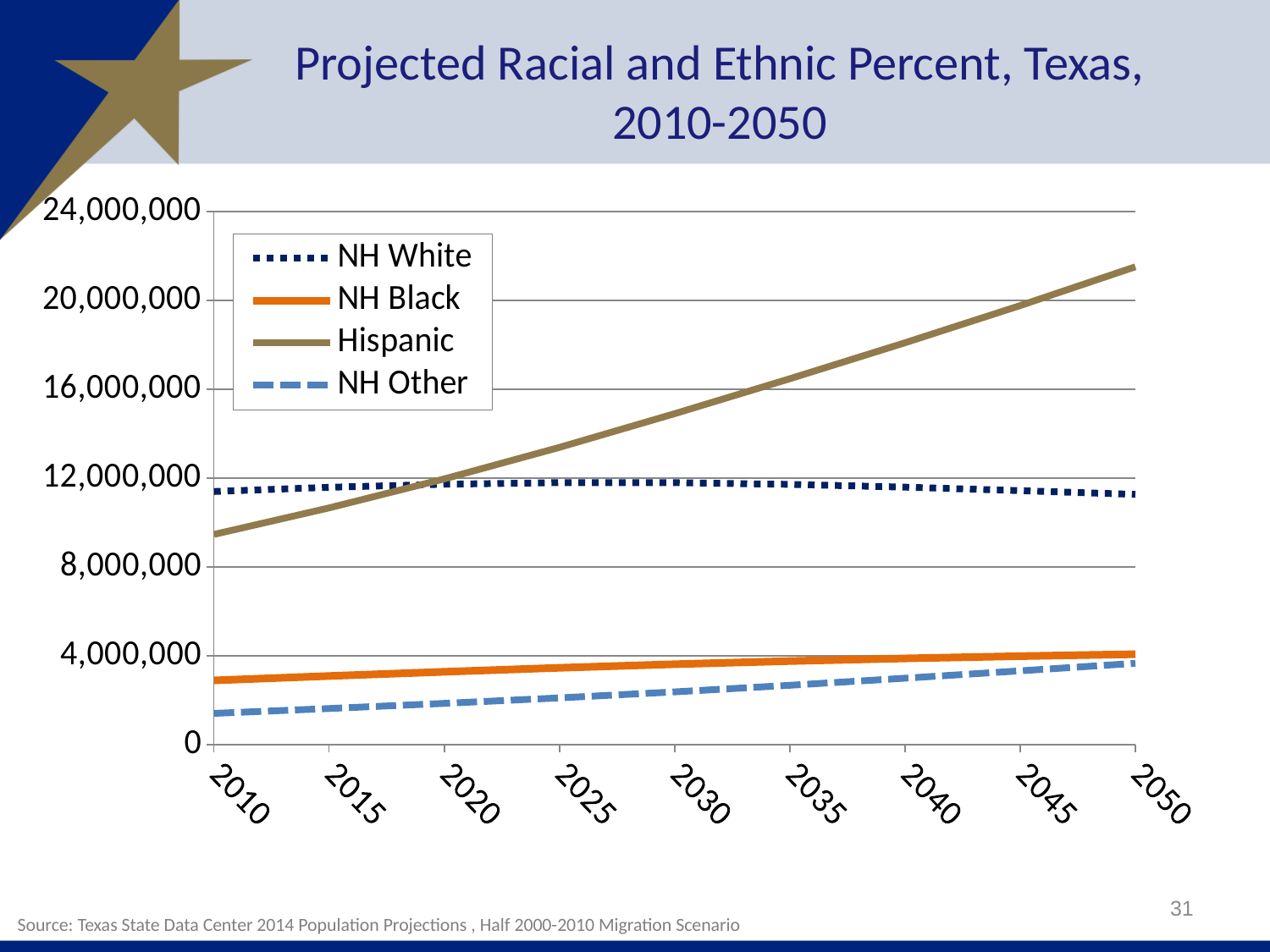
How many years are labelled along the x axis? 9 Does the NH Other line rise or fall from 2010 to 2050? rise Which series has the highest value in 2050? Hispanic In 2010, which is larger: NH White or Hispanic? NH White What is the title of the chart? Projected Racial and Ethnic Percent, Texas, 2010-2050 In 2050, which is larger: NH White or Hispanic? Hispanic Which series has the lowest value in 2010? NH Other How many series does the legend list? 4 Is the Hispanic value in 2050 greater or less than 20,000,000? greater Does the Hispanic line rise or fall from 2010 to 2050? rise Is the NH Other value in 2010 greater or less than 4,000,000? less What kind of chart is shown on the slide? line chart